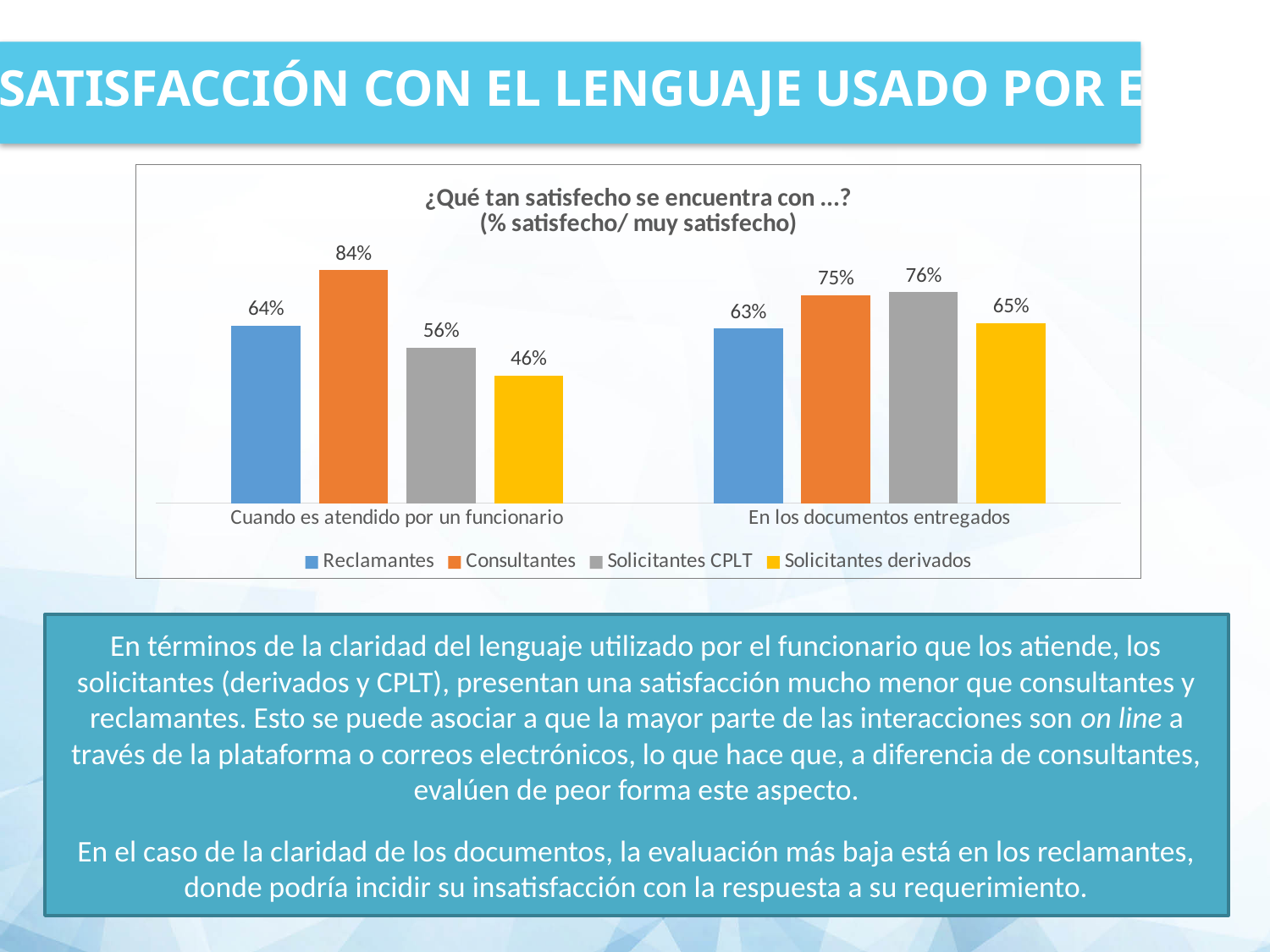
What kind of chart is shown on the slide? Bar chart Which series has the lowest value in the category 'En los documentos entregados'? Reclamantes What is the value for Solicitantes derivados in the category 'En los documentos entregados'? 65% What is the value for Reclamantes in the category 'En los documentos entregados'? 63% What is the difference between the Consultantes value and the Solicitantes derivados value in the category 'Cuando es atendido por un funcionario'? 38% Which series has the highest value in the category 'Cuando es atendido por un funcionario'? Consultantes How many categories are shown on the x axis? 2 What is the difference between the Solicitantes CPLT values in the two categories? 20% What is the value for Consultantes in the category 'Cuando es atendido por un funcionario'? 84% Which series has the lowest value in the category 'Cuando es atendido por un funcionario'? Solicitantes derivados How many series does the legend list? 4 Which is larger: the Reclamantes value for 'Cuando es atendido por un funcionario' or the Solicitantes derivados value for 'Cuando es atendido por un funcionario'? Reclamantes